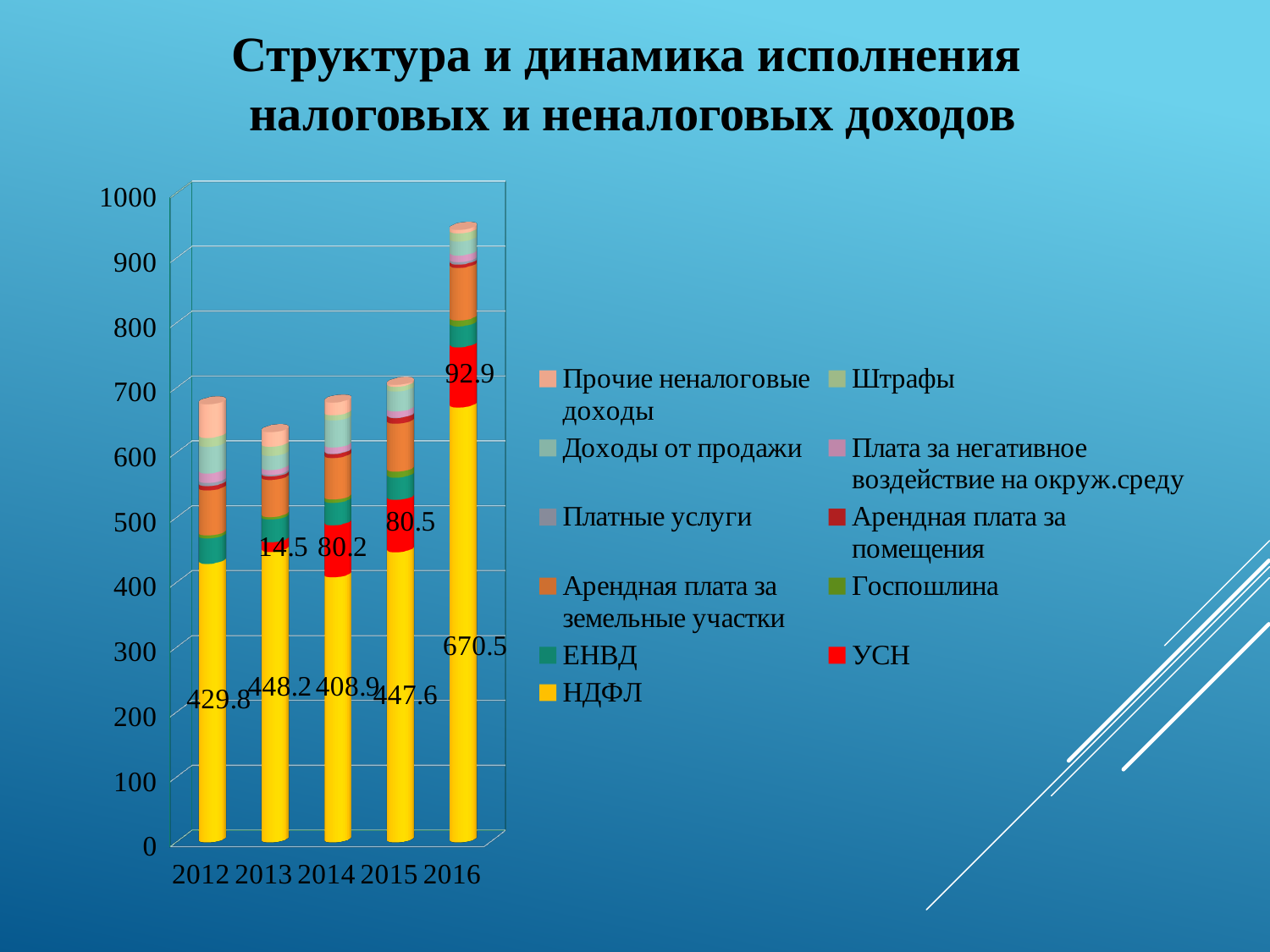
In which year is the НДФЛ value the highest? 2016 In which year is the НДФЛ value the lowest? 2014 How many years are shown on the x axis? 5 Does the НДФЛ value rise or fall from 2014 to 2016? rise Is the total height of the 2016 stacked bar greater or less than 900? greater How many series does the legend list? 11 What is the value of НДФЛ for 2014? 408.9 What is the value of НДФЛ for 2016? 670.5 What is the difference between the НДФЛ values for 2016 and 2015? 222.9 What is the value of УСН for 2013? 14.5 What kind of chart is shown on the slide? stacked bar chart Which year has the larger УСН value, 2013 or 2016? 2016